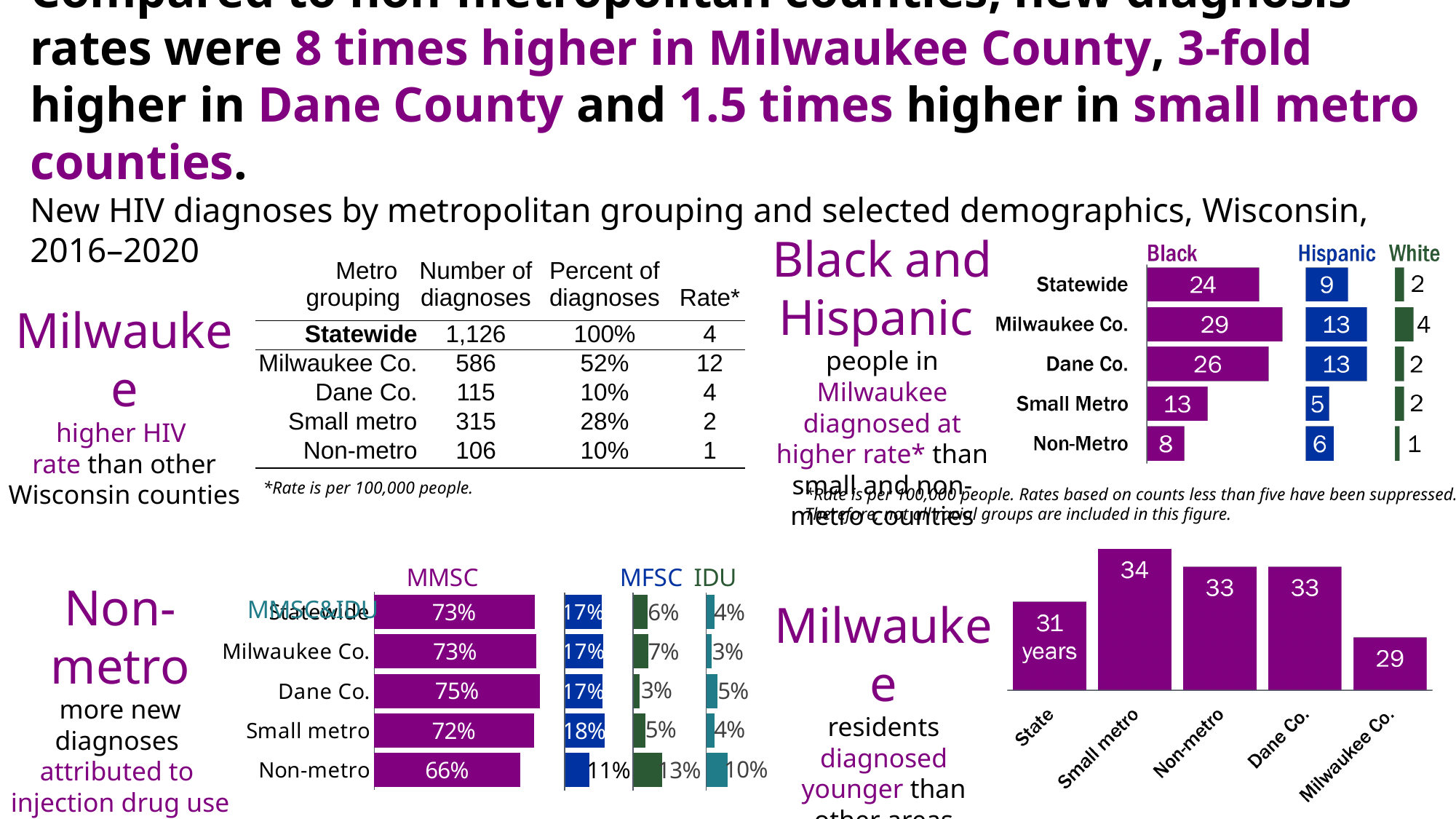
In the top-right chart of rates by race/ethnicity, what is the difference between the Black rate in Milwaukee Co. and the Black rate in Non-Metro counties? 21 In the bottom-right chart of age at diagnosis, what is the value for Milwaukee Co.? 29 How many series (race/ethnicity groups) does the top-right chart show? 3 In the bottom-left chart of transmission categories, which metro grouping has the highest MMSC percentage? Dane Co. In the top-right chart of rates by race/ethnicity, what is the rate for Black people in Milwaukee Co.? 29 What type of chart is the bottom-right chart of age at diagnosis? bar chart How many metro groupings are shown in the bottom-right chart of age at diagnosis? 5 In the bottom-left chart of transmission categories, what is the MMSC percentage for Non-metro counties? 66% In the top-right chart of rates by race/ethnicity, which metro grouping has the highest rate for Black people? Milwaukee Co. In the bottom-left chart of transmission categories, which is larger: the MMSC&IDU percentage for Dane Co. or for Milwaukee Co.? Dane Co. In the bottom-left chart of transmission categories, what is the IDU percentage for Non-metro counties? 13% In the top-right chart of rates by race/ethnicity, what is the Hispanic rate for Non-Metro counties? 6